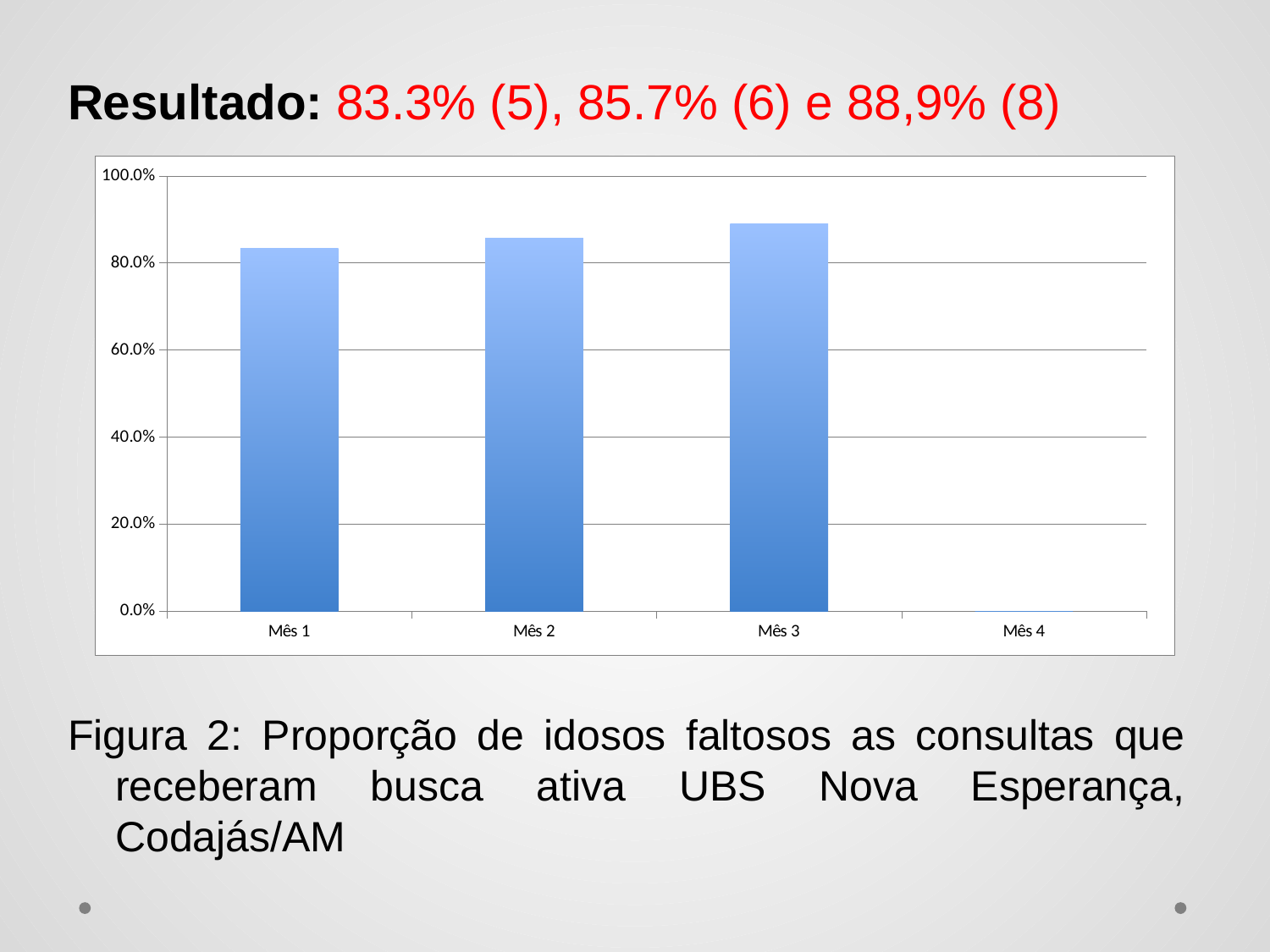
Is the value for Mês 2 greater or less than 60.0%? greater Is the value for Mês 3 greater or less than 100.0%? less Which is larger, the value for Mês 1 or the value for Mês 3? Mês 3 Do the values rise or fall from Mês 1 to Mês 3? rise What kind of chart is shown on the slide? bar chart What figure number is given in the caption below the chart? Figura 2 What is the value shown for Mês 4 in the chart? 0.0% Is the value for Mês 1 greater or less than 80.0%? greater Which month has the highest bar in the chart? Mês 3 Which month has the lowest value in the chart? Mês 4 How many categories (months) are shown on the x axis of the chart? 4 What is the highest tick value shown on the y axis of the chart? 100.0%